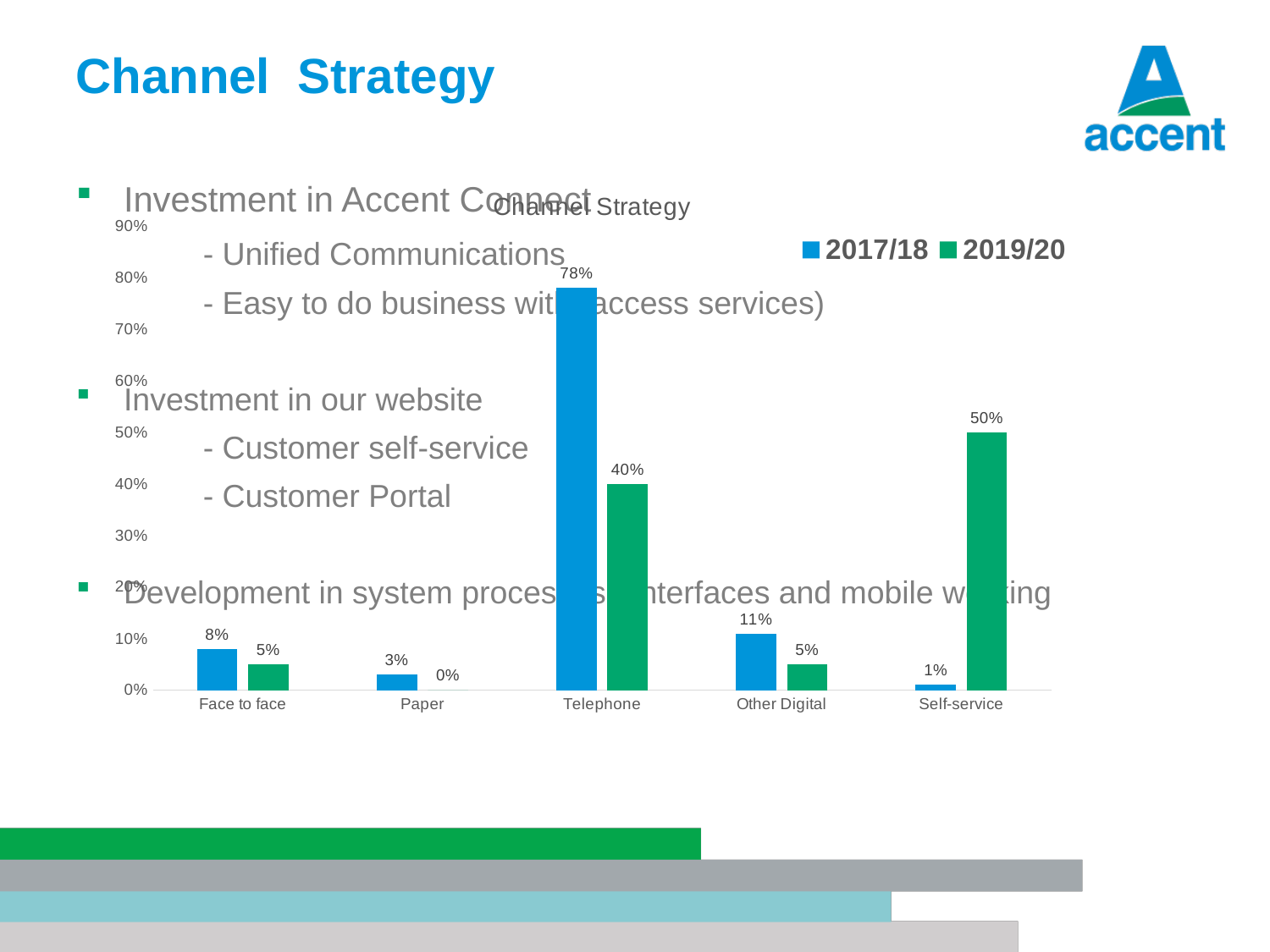
How many series does the legend list? 2 What is the value for Other Digital in the 2017/18 series? 11% Which category has the lowest value in the 2019/20 series? Paper What is the value for Telephone in the 2017/18 series? 78% What kind of chart is shown on the slide? Bar chart What is the difference between the 2017/18 and 2019/20 values for Telephone? 38% What is the title of the chart? Channel Strategy What is the value for Self-service in the 2019/20 series? 50% How many categories are shown on the x axis? 5 Which category has the highest value in the 2017/18 series? Telephone What is the value for Paper in the 2019/20 series? 0% Which is larger for Self-service: the 2017/18 value or the 2019/20 value? 2019/20